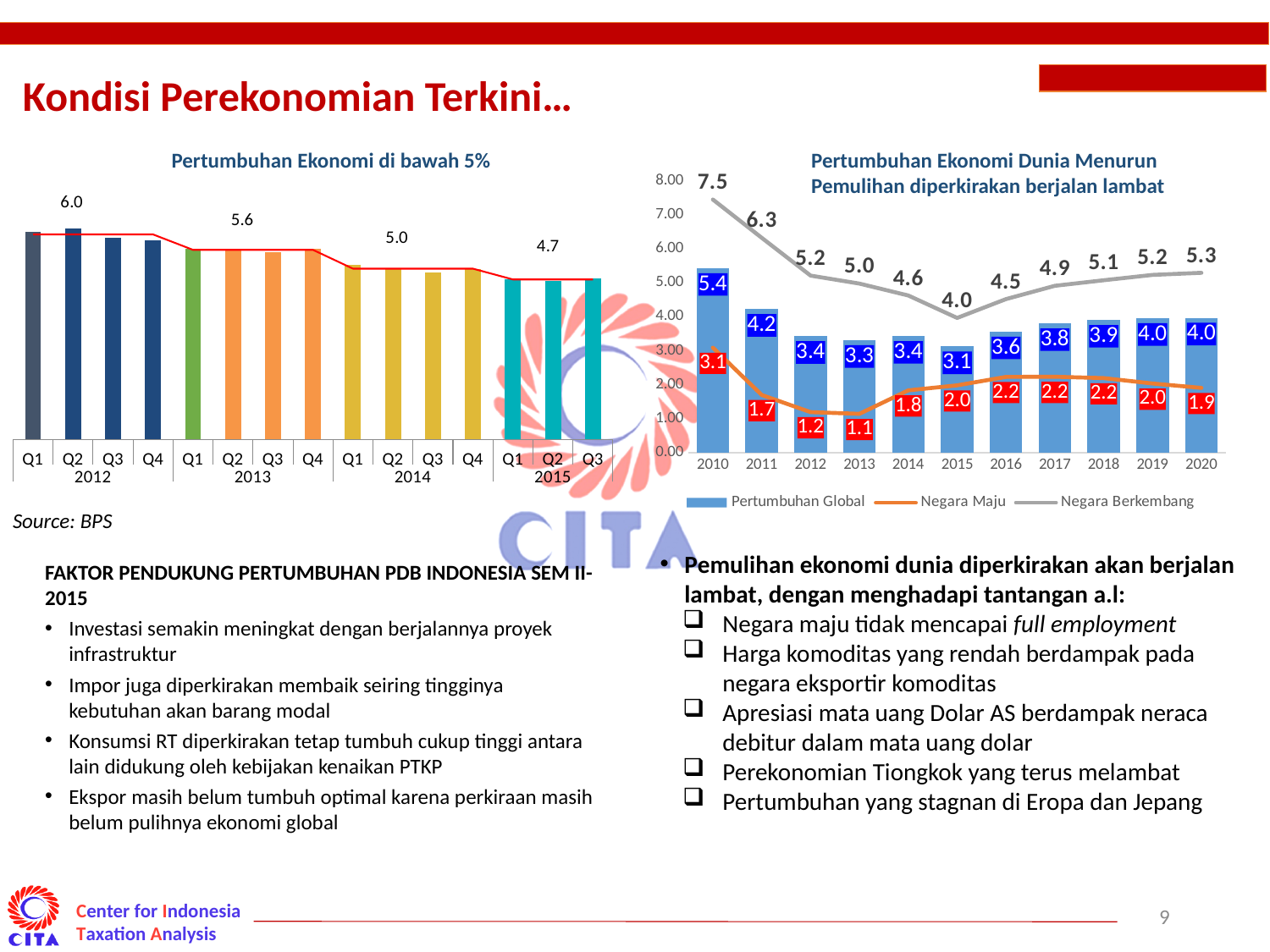
In the right chart (Pertumbuhan Ekonomi Dunia Menurun), what is the Negara Maju value for 2013? 1.1 In the right chart (Pertumbuhan Ekonomi Dunia Menurun), which year has the lowest Negara Maju value? 2013 In the right chart (Pertumbuhan Ekonomi Dunia Menurun), what is the difference between the Negara Berkembang values for 2010 and 2020? 2.2 In the right chart (Pertumbuhan Ekonomi Dunia Menurun), what is the Pertumbuhan Global value for 2010? 5.4 How many years are shown on the x axis of the right chart (Pertumbuhan Ekonomi Dunia Menurun)? 11 What kind of chart is the left chart (Pertumbuhan Ekonomi di bawah 5%)? bar chart In the right chart (Pertumbuhan Ekonomi Dunia Menurun), which year has the highest Pertumbuhan Global value? 2010 In the left chart (Pertumbuhan Ekonomi di bawah 5%), what value is labelled for 2013? 5.6 In the right chart (Pertumbuhan Ekonomi Dunia Menurun), what is the Negara Berkembang value for 2015? 4.0 How many series does the legend of the right chart (Pertumbuhan Ekonomi Dunia Menurun) list? 3 In the left chart (Pertumbuhan Ekonomi di bawah 5%), do the annual labelled values rise or fall from 2012 to 2015? fall In the right chart (Pertumbuhan Ekonomi Dunia Menurun), which year has the larger Pertumbuhan Global value, 2011 or 2012? 2011